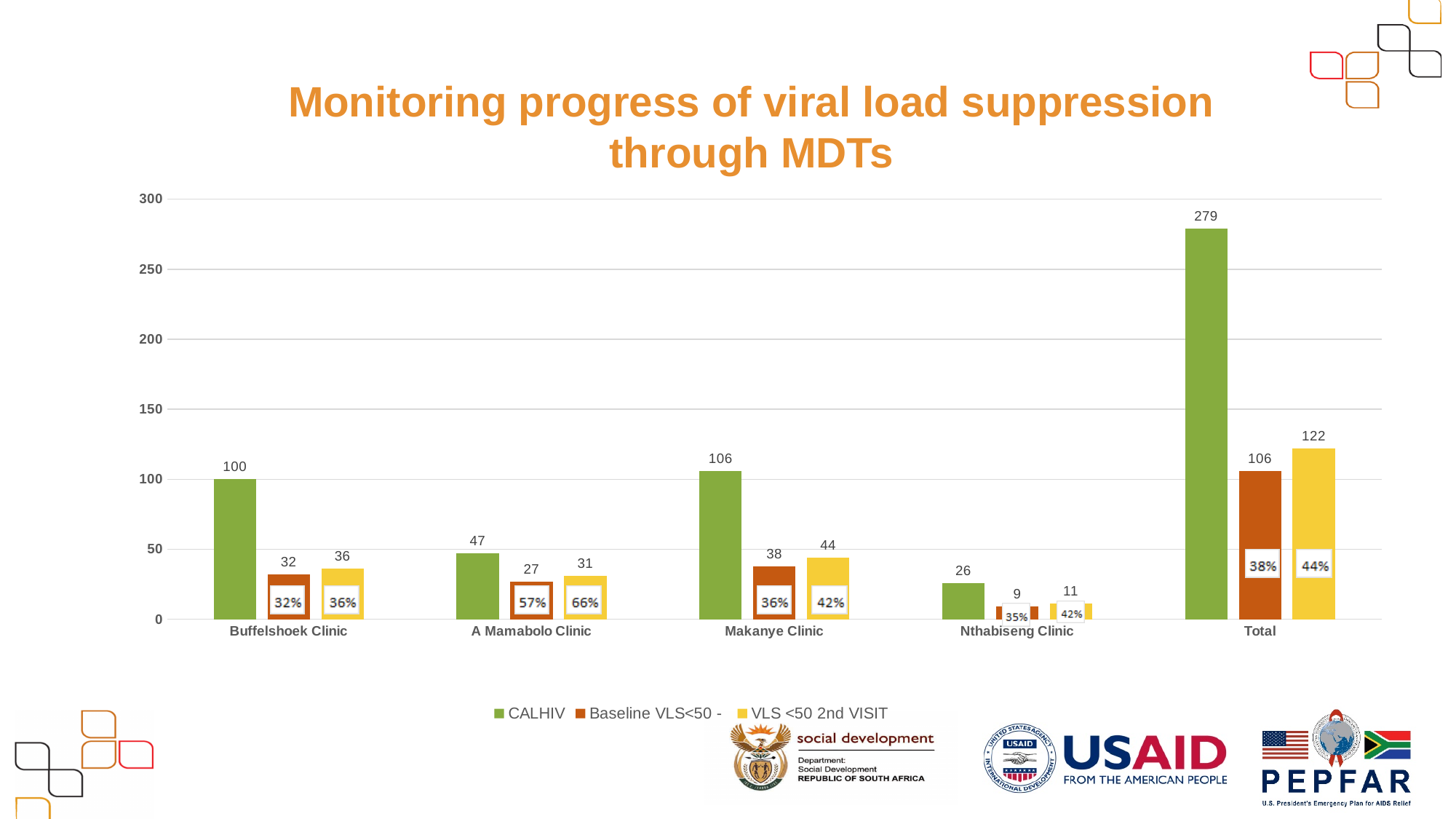
Which is larger for Makanye Clinic: the Baseline VLS<50 value or the VLS <50 2nd VISIT value? VLS <50 2nd VISIT Which clinic (excluding Total) has the lowest CALHIV value? Nthabiseng Clinic What kind of chart is shown on the slide? Bar chart What is the VLS <50 2nd VISIT value for the Total category? 122 How many categories are shown on the x axis? 5 How many series does the legend list? 3 What is the Baseline VLS<50 value for A Mamabolo Clinic? 27 Is the CALHIV value for Total greater or less than 250? greater Which category has the highest CALHIV value? Total What is the difference between the VLS <50 2nd VISIT and Baseline VLS<50 values for Buffelshoek Clinic? 4 What percentage label is shown on the VLS <50 2nd VISIT bar for A Mamabolo Clinic? 66% What is the CALHIV value for Makanye Clinic? 106